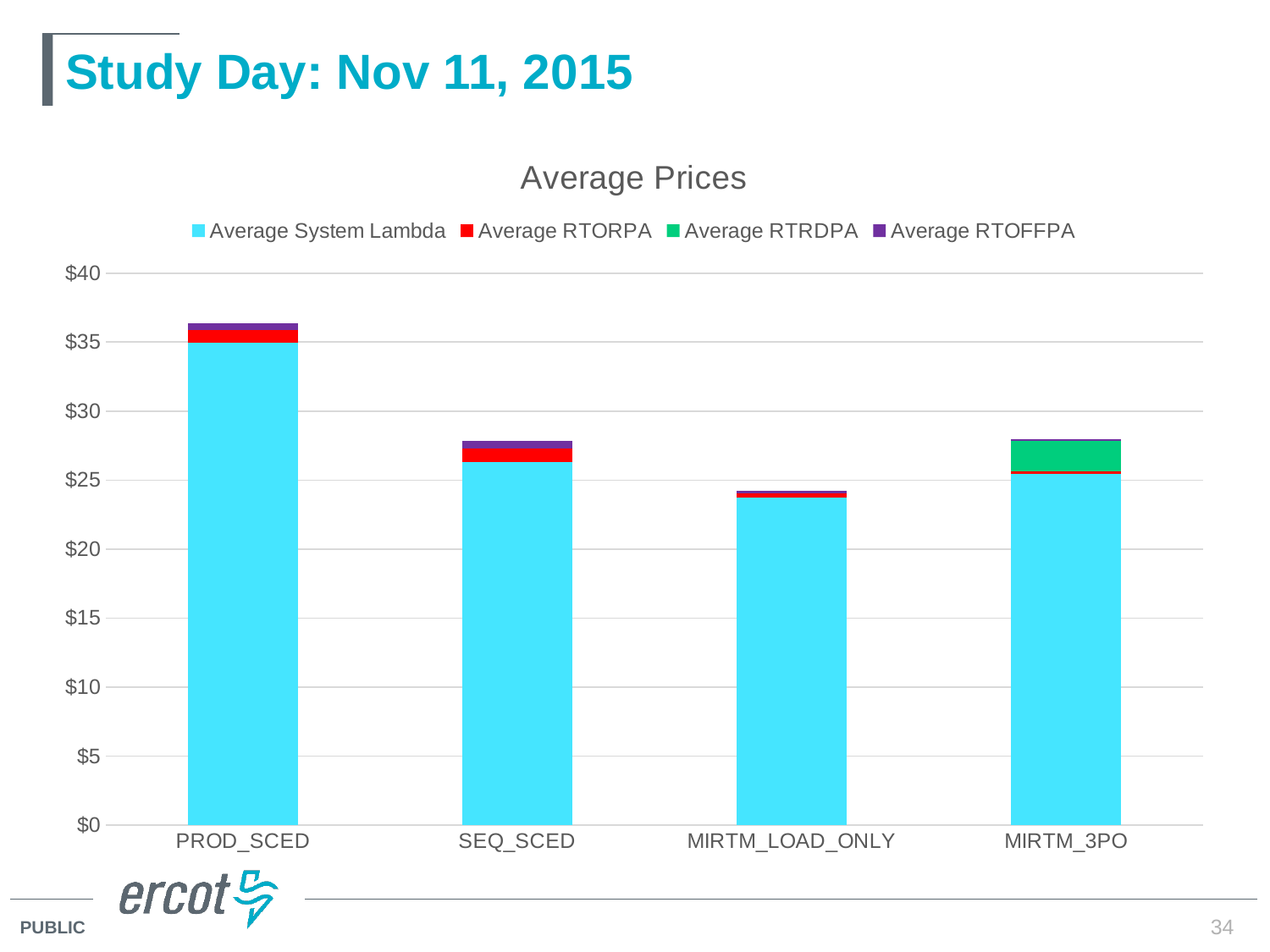
Is the Average System Lambda value for SEQ_SCED greater or less than $25? greater Is the total stacked value for PROD_SCED greater or less than $35? greater How many series does the legend list? 4 Which category has the highest total stacked bar? PROD_SCED What is the title of the chart? Average Prices Which category has the lowest total stacked bar? MIRTM_LOAD_ONLY Which has the larger total stacked bar, PROD_SCED or SEQ_SCED? PROD_SCED Is the total stacked value for MIRTM_LOAD_ONLY greater or less than $25? less Which category is the only one with a visible Average RTRDPA (green) segment? MIRTM_3PO What kind of chart is shown on the slide? Stacked bar chart How many categories are shown on the x axis? 4